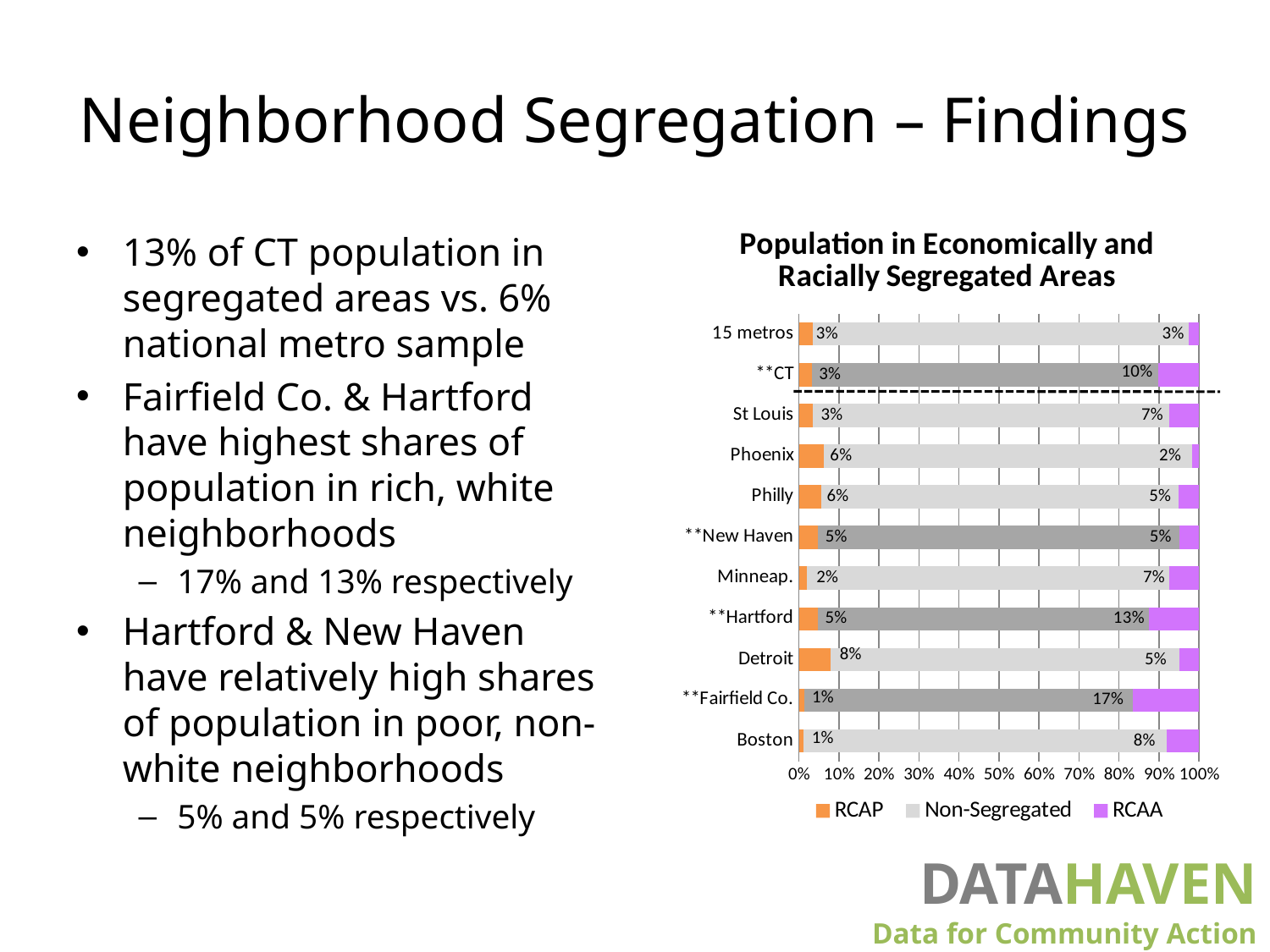
Which category has the highest RCAA value? **Fairfield Co. Which category has the lowest RCAA value? Phoenix Which category has the highest RCAP value? Detroit How many series does the legend list? 3 What is the RCAP value for Minneap.? 2% What kind of chart is shown on the slide? Stacked bar chart Which is larger, the RCAA value for Boston or the RCAA value for St Louis? Boston What is the RCAA value for **Hartford? 13% How many categories are shown on the chart? 11 What is the difference between the RCAA values for **Fairfield Co. and **Hartford? 4% What is the RCAA value for **CT? 10% What is the RCAP value for Detroit? 8%